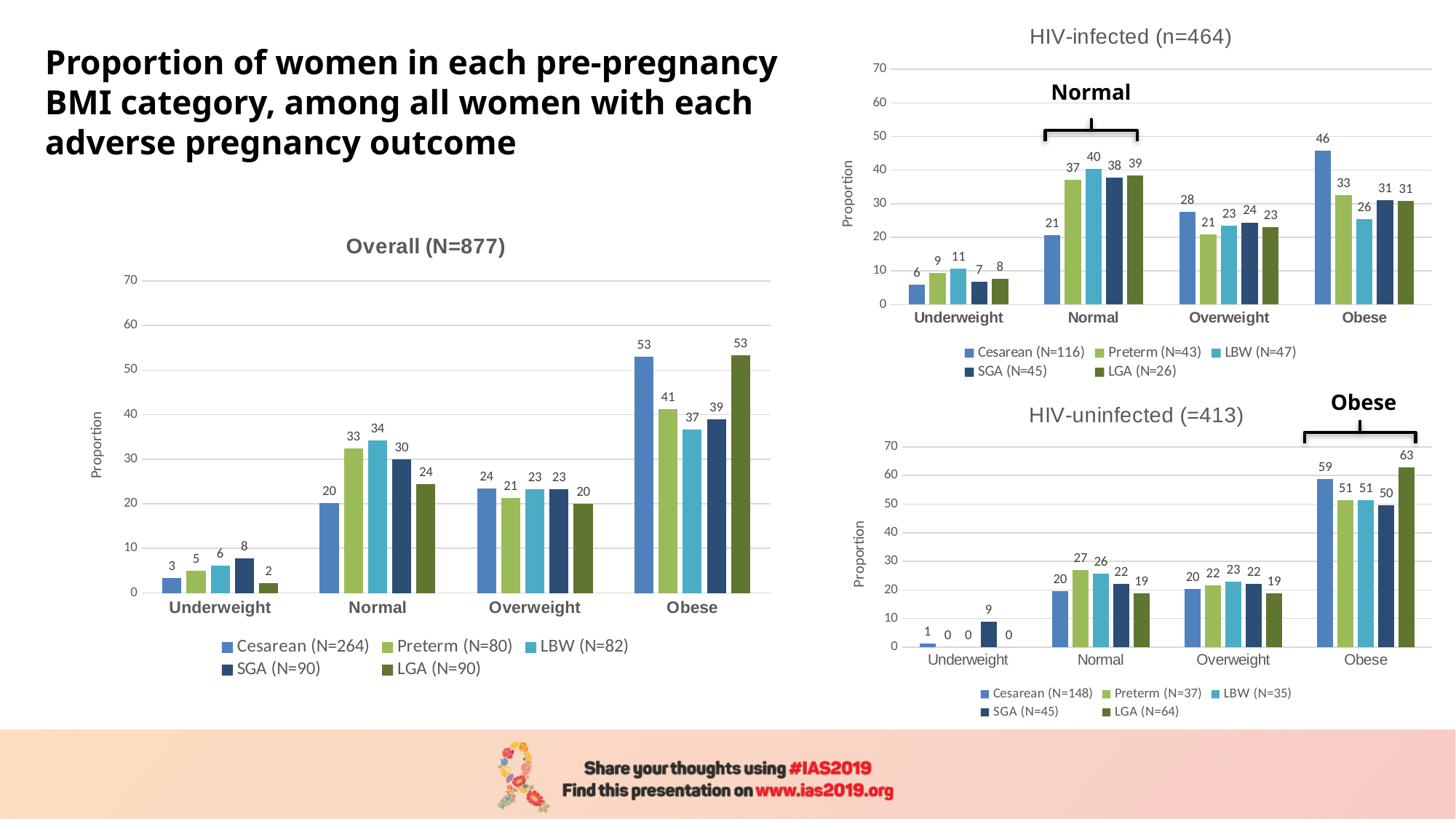
In the HIV-uninfected (=413) chart, which series has the highest value in the Underweight category? SGA (N=45) In the HIV-uninfected (=413) chart, what is the value for LGA (N=64) in the Obese category? 63 In the HIV-uninfected (=413) chart, is the value for Cesarean (N=148) in the Obese category greater or less than 50? greater In the HIV-infected (n=464) chart, what is the value for LBW (N=47) in the Normal category? 40 In the Overall (N=877) chart, what is the value for Cesarean (N=264) in the Obese category? 53 In the HIV-infected (n=464) chart, what is the difference between the Cesarean (N=116) and LBW (N=47) values in the Obese category? 20 In the HIV-infected (n=464) chart, what is the sample size shown in the legend for Preterm? N=43 What kind of chart is the HIV-uninfected (=413) chart? Bar chart How many series does the legend of the Overall (N=877) chart list? 5 In the Overall (N=877) chart, which is larger in the Normal category: Preterm (N=80) or SGA (N=90)? Preterm (N=80) How many BMI categories are shown on the x axis of the HIV-infected (n=464) chart? 4 In the Overall (N=877) chart, which series has the lowest value in the Underweight category? LGA (N=90)